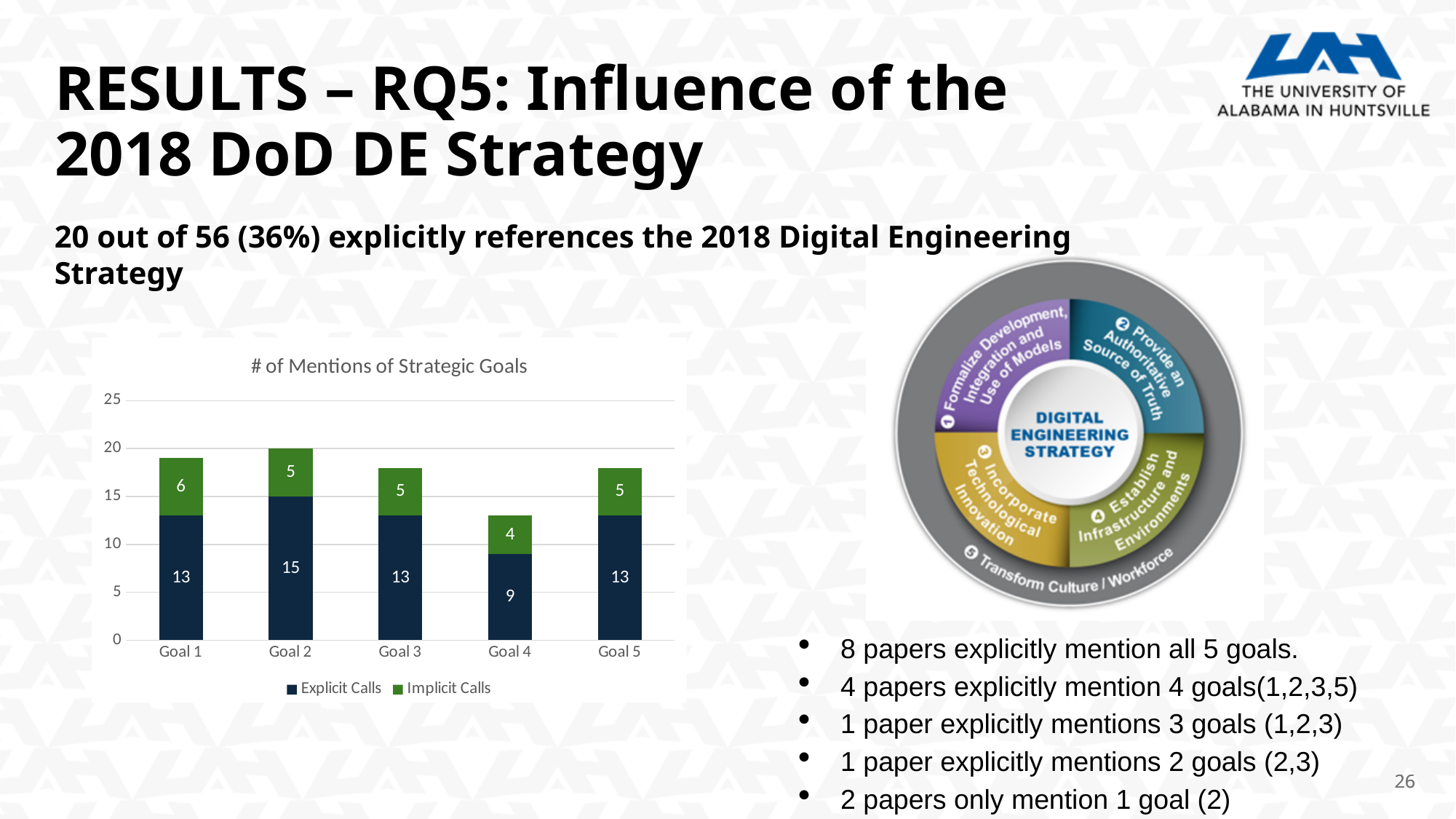
Which goal has the highest number of Explicit Calls? Goal 2 What is the value of Implicit Calls for Goal 1? 6 What type of chart is used to show the number of mentions of strategic goals? Stacked bar chart What is the value of Explicit Calls for Goal 2? 15 What is the difference between Explicit Calls for Goal 2 and Explicit Calls for Goal 4? 6 What is the value of Explicit Calls for Goal 4? 9 What is the total number of mentions (Explicit plus Implicit Calls) for Goal 2? 20 Which goal has the lowest number of Implicit Calls? Goal 4 Which is larger: Implicit Calls for Goal 1 or Implicit Calls for Goal 3? Implicit Calls for Goal 1 How many goals (categories) are shown on the x axis of the chart? 5 What is the total number of mentions (Explicit plus Implicit Calls) for Goal 4? 13 How many series does the chart legend list? 2